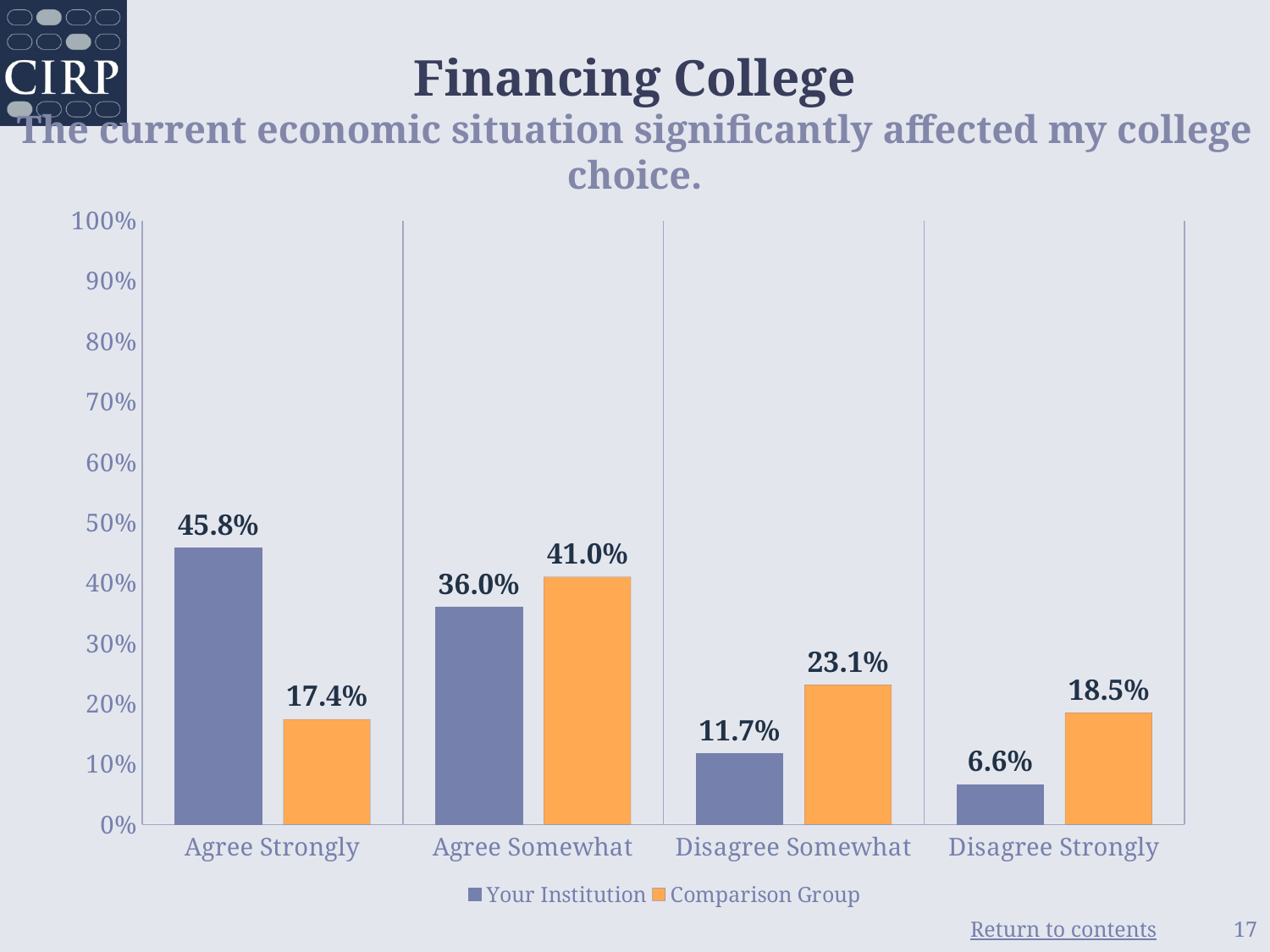
How many series does the legend list? 2 Which category has the highest value for Comparison Group? Agree Somewhat How many categories are shown on the x axis? 4 Which category has the lowest value for Your Institution? Disagree Strongly What is the value for Comparison Group in the Disagree Somewhat category? 23.1% What is the value for Your Institution in the Disagree Strongly category? 6.6% What is the difference between Your Institution and Comparison Group in the Agree Strongly category? 28.4% Which series is shown in orange? Comparison Group What is the value for Your Institution in the Agree Strongly category? 45.8% Is the value for Comparison Group in the Disagree Strongly category greater or less than 20%? less In the Agree Somewhat category, which series has the larger value, Your Institution or Comparison Group? Comparison Group What kind of chart is shown on the slide? Bar chart